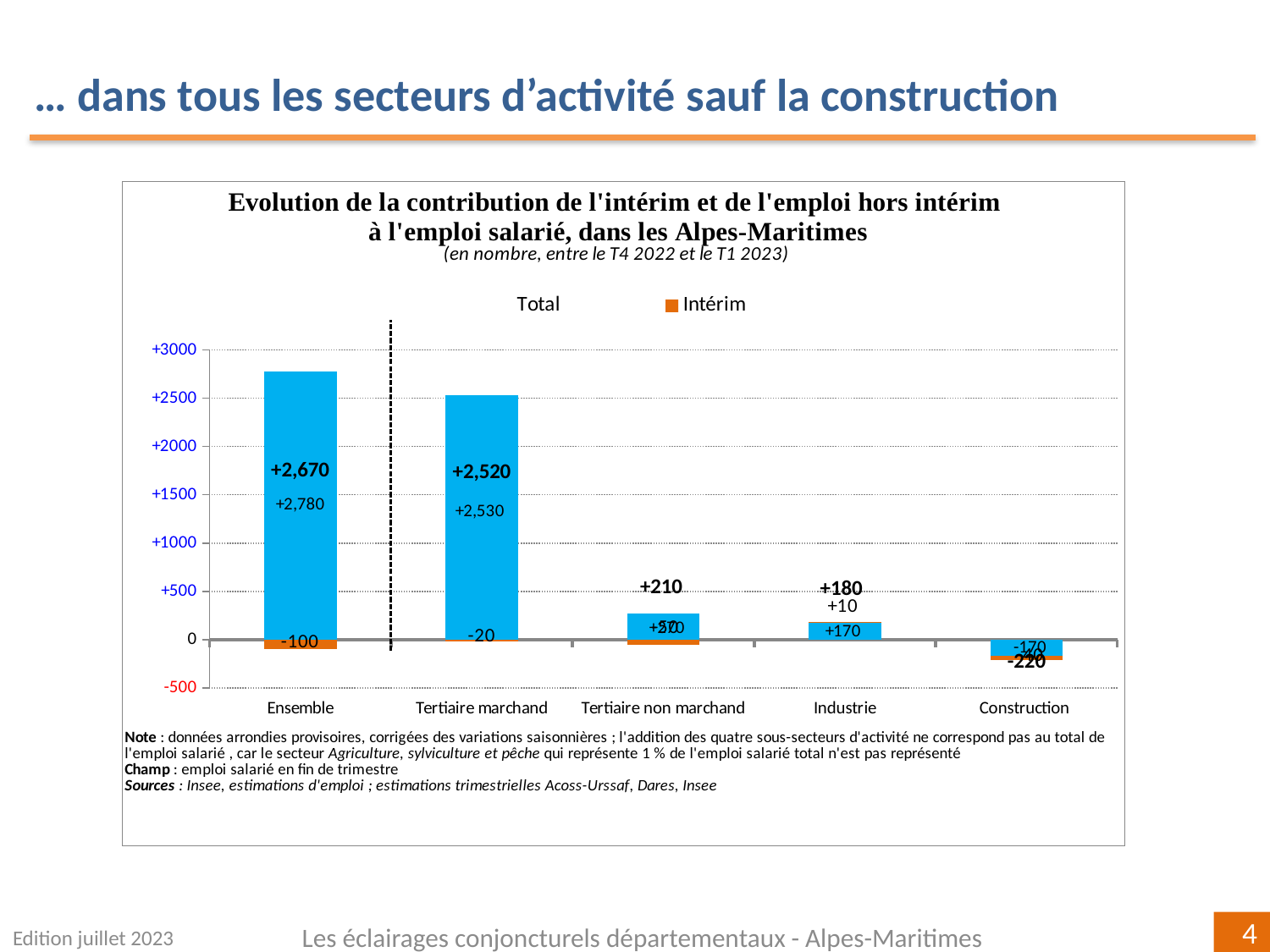
Which two entries does the legend list? Total and Intérim How many sectors (categories) are shown along the x axis? 5 What is the total value shown for Construction? -220 What is the total value shown for Tertiaire marchand? +2,520 What is the Intérim value shown for Ensemble? -100 What kind of chart is shown on the slide? bar chart Which has the larger total value, Tertiaire non marchand or Industrie? Tertiaire non marchand What is the total value shown for Industrie? +180 Which sector has the highest total value? Ensemble What is the total value shown for Ensemble? +2,670 What is the difference between the total values for Ensemble (+2,670) and Tertiaire marchand (+2,520)? 150 Which sector has the lowest total value? Construction